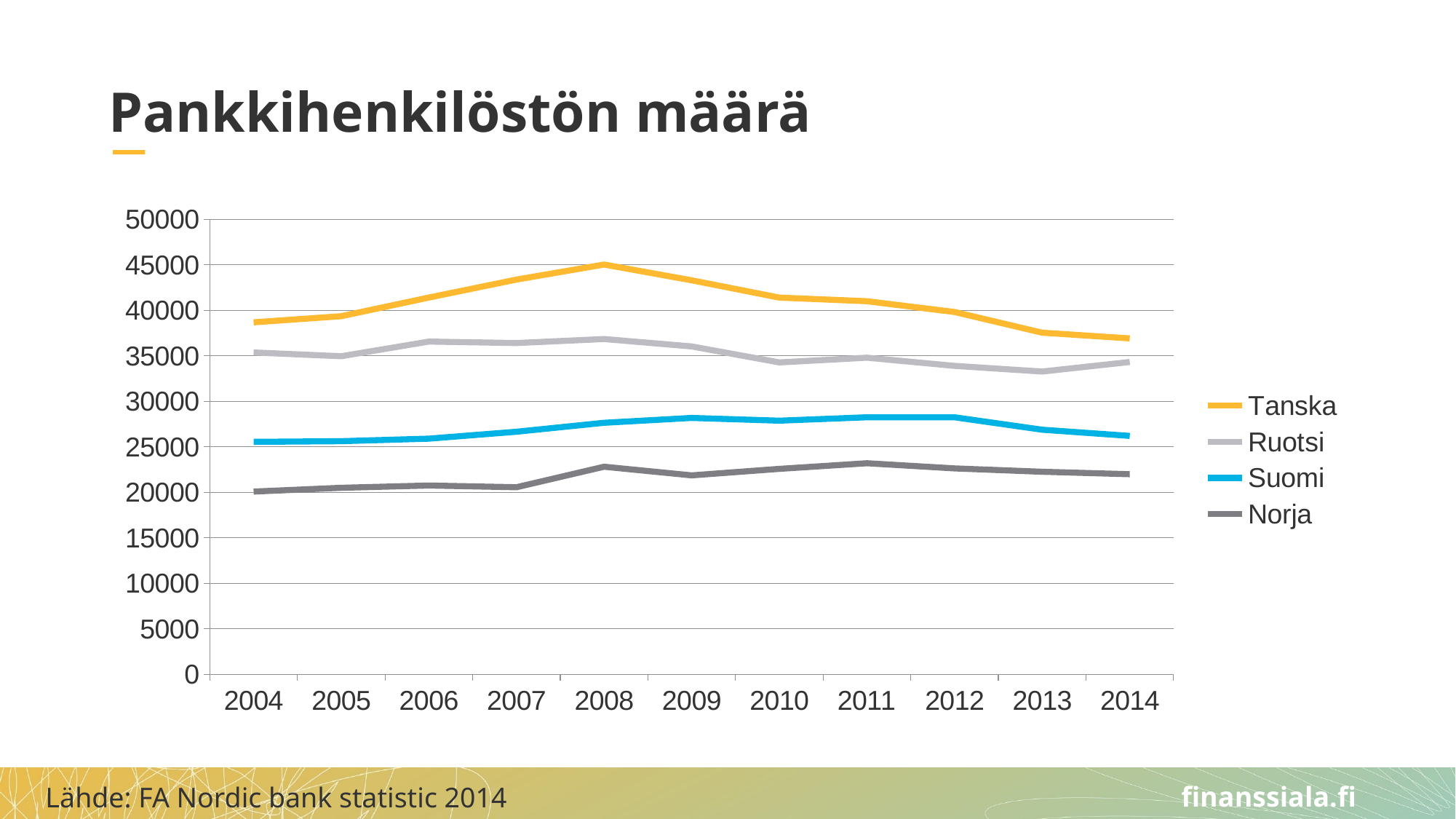
In which year does the Tanska line reach its highest point? 2008 What is the title of the chart? Pankkihenkilöstön määrä In 2010, which is larger: the value for Ruotsi or the value for Suomi? Ruotsi Is the value for Tanska in 2004 greater or less than 35000? greater Which country has the lowest number of bank staff across all years shown? Norja Does the Tanska line rise or fall from 2008 to 2014? fall How many years are shown on the x axis? 11 How many series does the legend list? 4 Is the value for Ruotsi in 2013 greater or less than 35000? less Is the value for Suomi in 2009 greater or less than 25000? greater What kind of chart is shown on the slide? line chart Which country has the highest number of bank staff across all years shown? Tanska